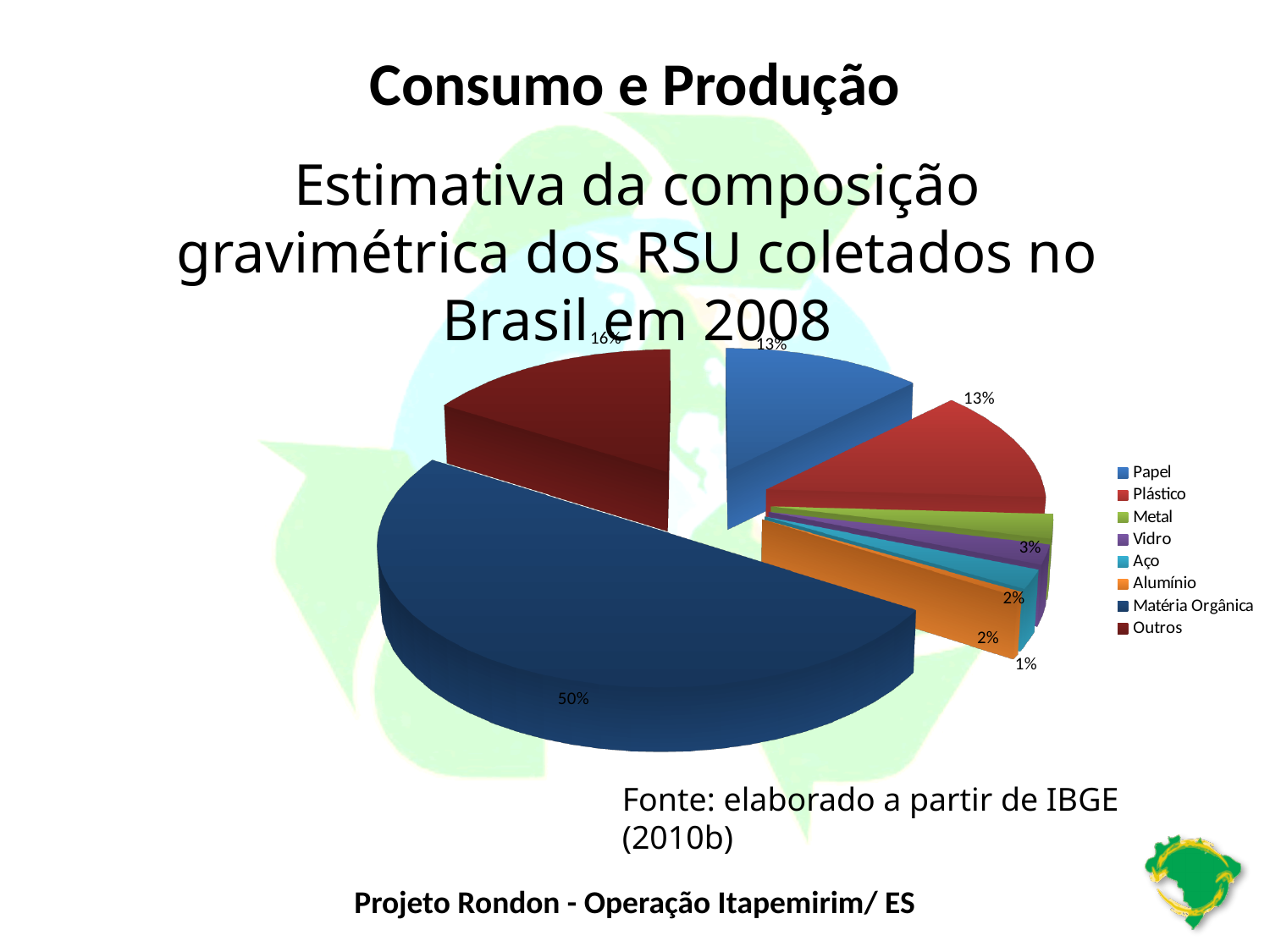
Which is larger, the slice for Outros or the slice for Papel? Outros How many categories does the legend list? 8 Which category has the largest slice of the pie? Matéria Orgânica What is the value shown for Plástico? 13% What percentage of the pie does Matéria Orgânica represent? 50% What is the value shown for Outros? 16% What is the value shown for Papel? 13% What share of the pie do Papel and Plástico make up together? 26% What is the title of the chart? Estimativa da composição gravimétrica dos RSU coletados no Brasil em 2008 Which legend entry is shown in dark red? Outros What type of chart is shown on the slide? Pie chart What is the difference in percentage points between Outros and Plástico? 3 percentage points